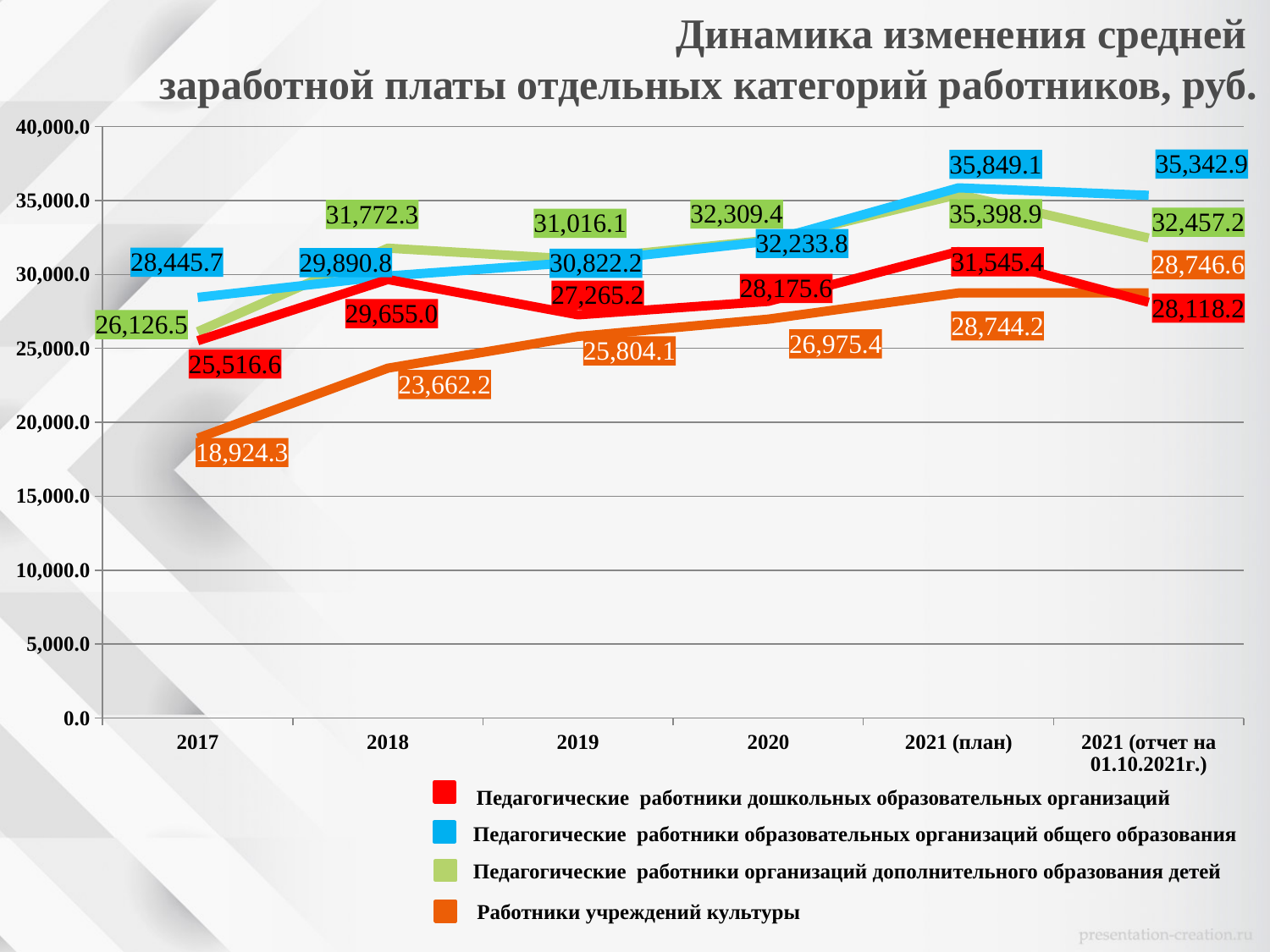
What is the value for Педагогические работники дошкольных образовательных организаций in 2019? 27,265.2 How many periods are shown on the x axis? 6 In which year is the value for Работники учреждений культуры the lowest? 2017 What is the average salary of Работники учреждений культуры in 2017? 18,924.3 By how much did the value for Работники учреждений культуры increase from 2017 to 2018? 4,737.9 In 2018, which is larger: the value for Педагогические работники дошкольных образовательных организаций or for Педагогические работники организаций дополнительного образования детей? Педагогические работники организаций дополнительного образования детей What kind of chart is shown on the slide? Line chart What is the value for Педагогические работники организаций дополнительного образования детей in 2020? 32,309.4 In which period is the value for Педагогические работники образовательных организаций общего образования the highest? 2021 (план) What is the value for Педагогические работники образовательных организаций общего образования in 2021 (план)? 35,849.1 What is the difference between the 2021 (план) and 2021 (отчет на 01.10.2021г.) values for Педагогические работники образовательных организаций общего образования? 506.2 How many series does the legend list? 4